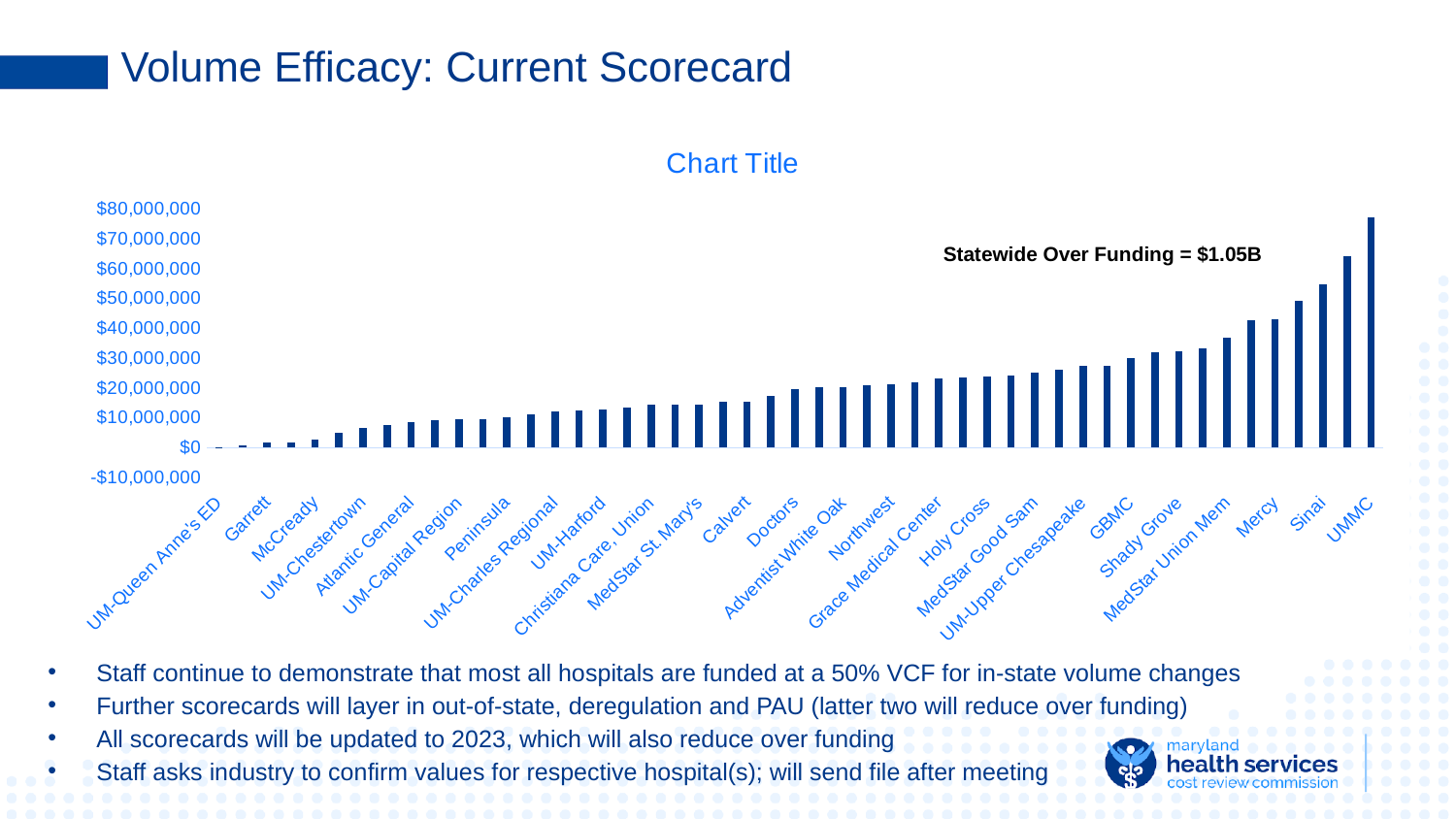
Which has the larger value, Holy Cross or Calvert? Holy Cross Which has the larger value, UMMC or Sinai? UMMC Do the values generally rise or fall moving from left to right along the x axis? Rise Is the value for Garrett greater or less than $10,000,000? less What statewide over funding amount is annotated on the chart? $1.05B What kind of chart is shown on the slide? Bar chart Is the value for Holy Cross greater or less than $30,000,000? less Is the value for UMMC greater or less than $70,000,000? greater Which hospital has the highest value in the chart? UMMC Which hospital has the lowest value in the chart? UM-Queen Anne's ED